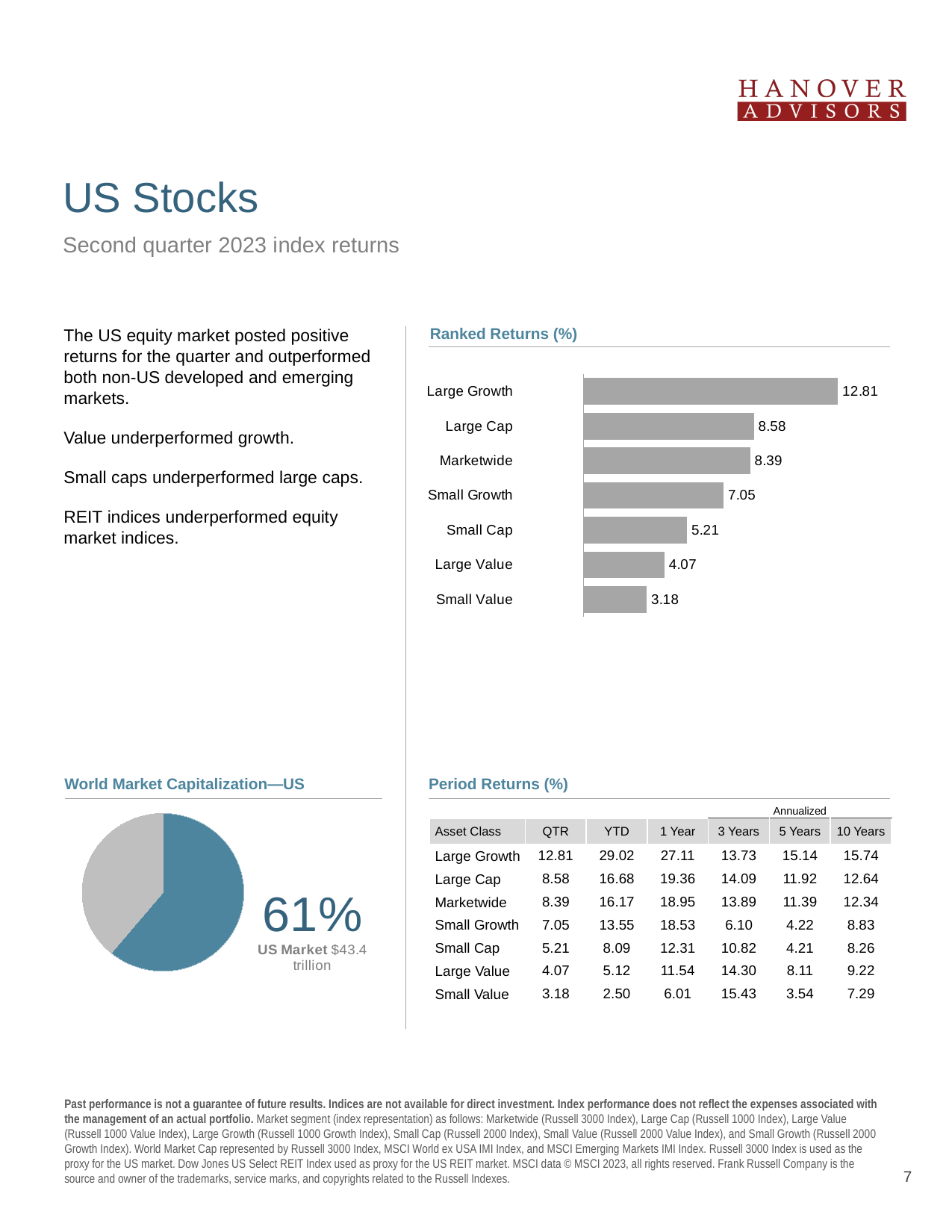
In the Ranked Returns (%) chart, which category has the highest value? Large Growth In the World Market Capitalization—US chart, what share of the pie does the US Market represent? 61% In the Ranked Returns (%) chart, what is the value for Small Cap? 5.21 What kind of chart is the World Market Capitalization—US chart? Pie chart In the Ranked Returns (%) chart, what is the difference between the values for Large Growth and Small Value? 9.63 In the Ranked Returns (%) chart, which is larger, the value for Large Value or the value for Small Value? Large Value How many categories are shown in the Ranked Returns (%) chart? 7 In the Ranked Returns (%) chart, what is the difference between the values for Small Growth and Small Cap? 1.84 In the World Market Capitalization—US chart, what dollar value is shown for the US Market? $43.4 trillion In the Ranked Returns (%) chart, what is the value for Large Growth? 12.81 In the Ranked Returns (%) chart, which category has the lowest value? Small Value What kind of chart is the Ranked Returns (%) chart? Bar chart